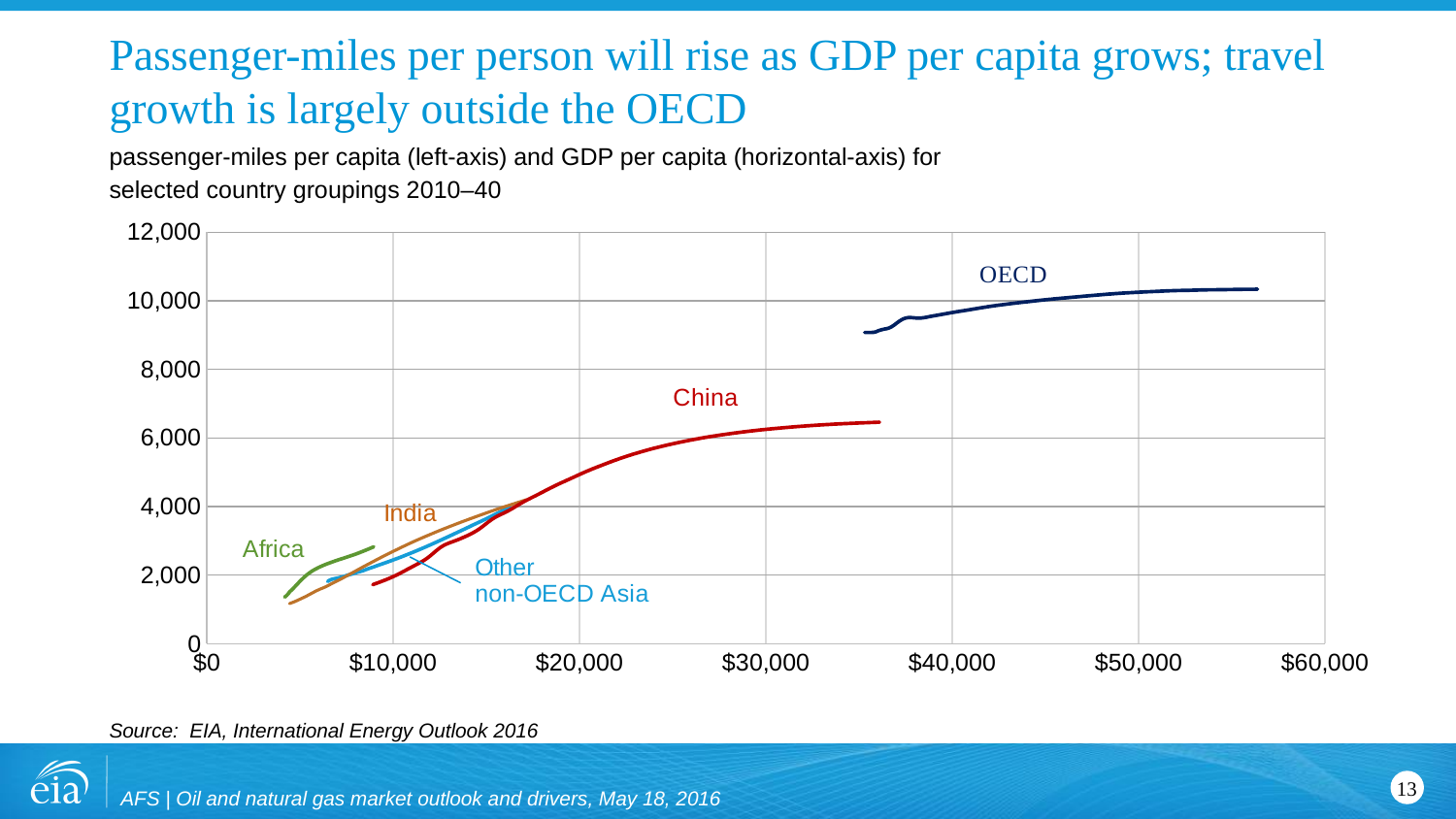
Which line extends to a higher GDP per capita on the horizontal axis, China or India? China What kind of chart is shown on the slide? line chart What is the maximum value shown on the vertical axis? 12,000 What source is cited for the chart? EIA, International Energy Outlook 2016 Which country grouping reaches the highest passenger-miles per capita on the chart? OECD Which line reaches higher passenger-miles per capita, OECD or China? OECD Which country grouping's line stays lowest in passenger-miles per capita at its endpoint? Africa How many country groupings are plotted as lines on the chart? 5 Is the highest passenger-miles per capita value reached by the Africa line greater or less than 4,000? less Do passenger-miles per capita rise or fall as GDP per capita increases along the China line? rise Is the highest passenger-miles per capita value reached by the OECD line greater or less than 10,000? greater Is the highest passenger-miles per capita value reached by the China line greater or less than 8,000? less